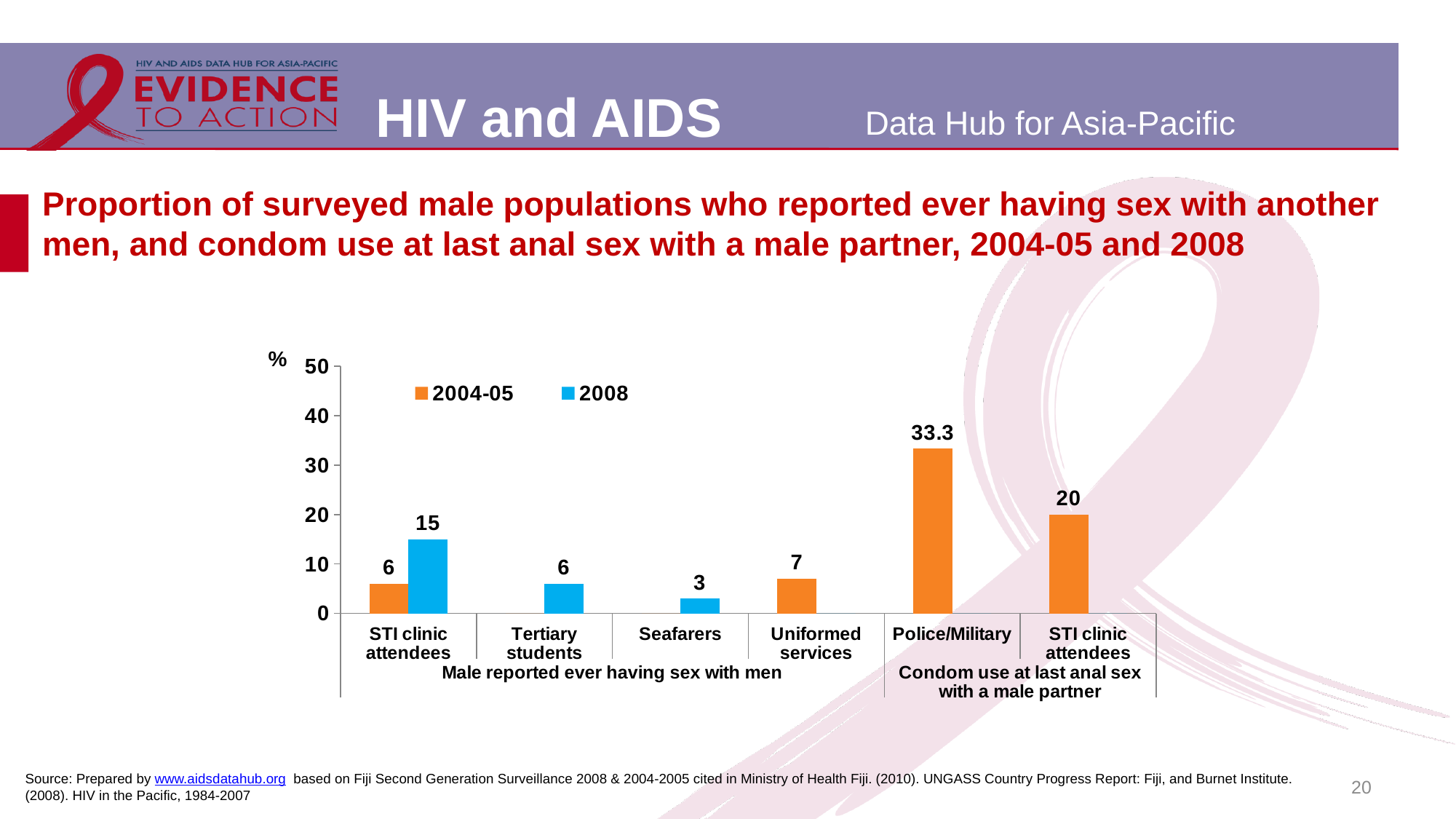
How many series does the legend list? 2 What is the 2004-05 value for Police/Military? 33.3 Which is larger: the 2004-05 value for Police/Military or the 2004-05 value for STI clinic attendees under condom use? Police/Military Which category has the lowest value on the chart? Seafarers What is the 2004-05 value for STI clinic attendees in the 'Male reported ever having sex with men' group? 6 What is the 2008 value for Seafarers? 3 What is the difference between the 2008 and 2004-05 values for STI clinic attendees in the 'Male reported ever having sex with men' group? 9 What kind of chart is shown on the slide? Bar chart What is the 2004-05 value for Uniformed services? 7 What is the 2004-05 value for STI clinic attendees in the 'Condom use at last anal sex with a male partner' group? 20 What is the 2008 value for STI clinic attendees in the 'Male reported ever having sex with men' group? 15 Which category has the highest value on the chart? Police/Military